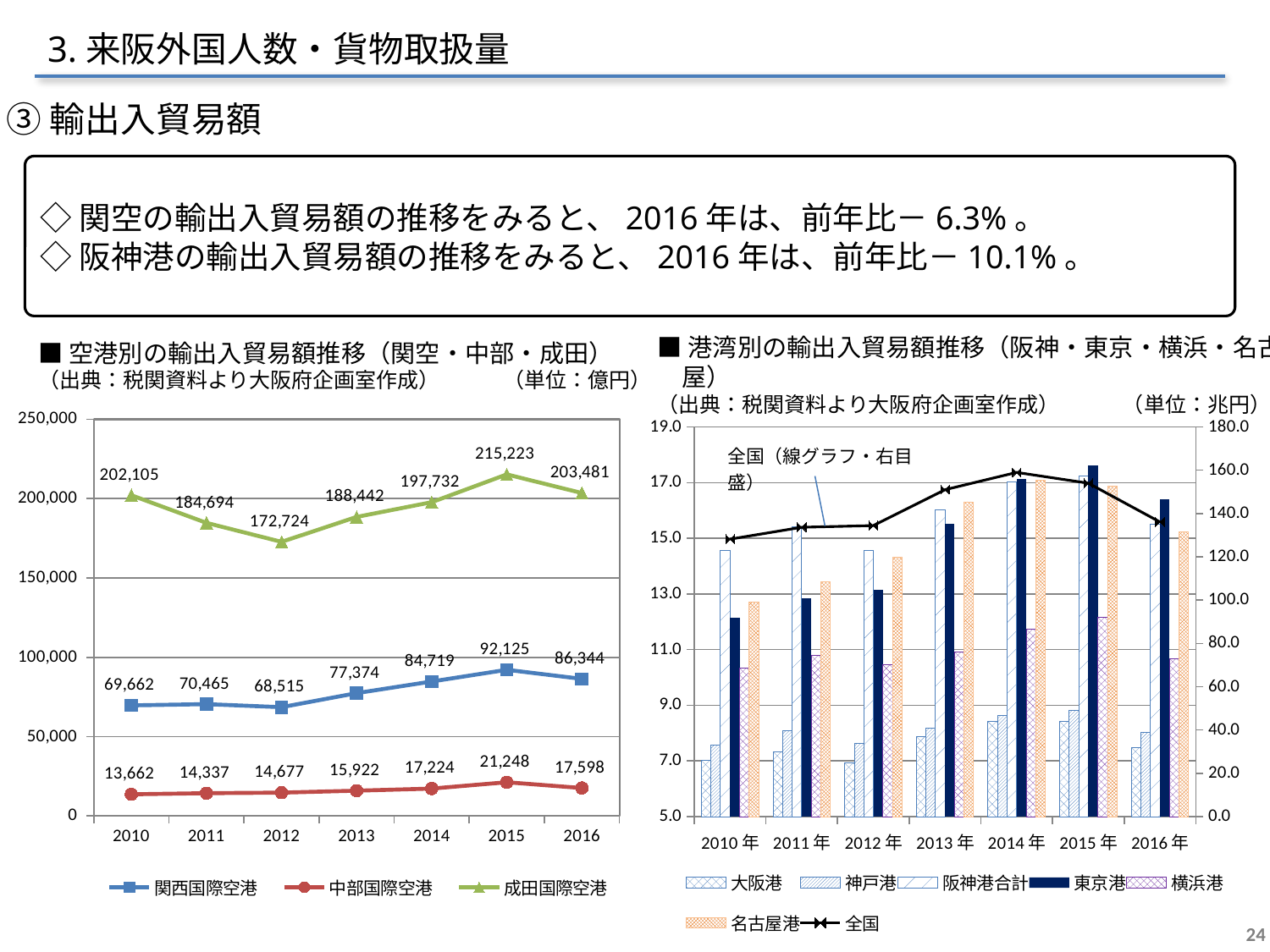
In the left chart (空港別の輸出入貿易額推移), which is larger: 関西国際空港 in 2013 or 関西国際空港 in 2014? 2014 In the left chart (空港別の輸出入貿易額推移), how many series does the legend list? 3 In the right chart (港湾別の輸出入貿易額推移), is the value for 阪神港合計 in 2016 greater or less than 15.0? greater In the left chart (空港別の輸出入貿易額推移), what is the value for 関西国際空港 in 2016? 86,344 In the left chart (空港別の輸出入貿易額推移), what is the value for 成田国際空港 in 2012? 172,724 In the left chart (空港別の輸出入貿易額推移), in which year is the value for 関西国際空港 lowest? 2012 In the left chart (空港別の輸出入貿易額推移), what is the value for 中部国際空港 in 2015? 21,248 In the right chart (港湾別の輸出入貿易額推移), is the value for 東京港 in 2010 greater or less than 13.0? less In the left chart (空港別の輸出入貿易額推移), what kind of chart is it? line chart In the left chart (空港別の輸出入貿易額推移), in which year is the value for 成田国際空港 highest? 2015 In the left chart (空港別の輸出入貿易額推移), what is the difference between the 成田国際空港 values for 2015 and 2016? 11,742 In the right chart (港湾別の輸出入貿易額推移), how many series does the legend list? 7